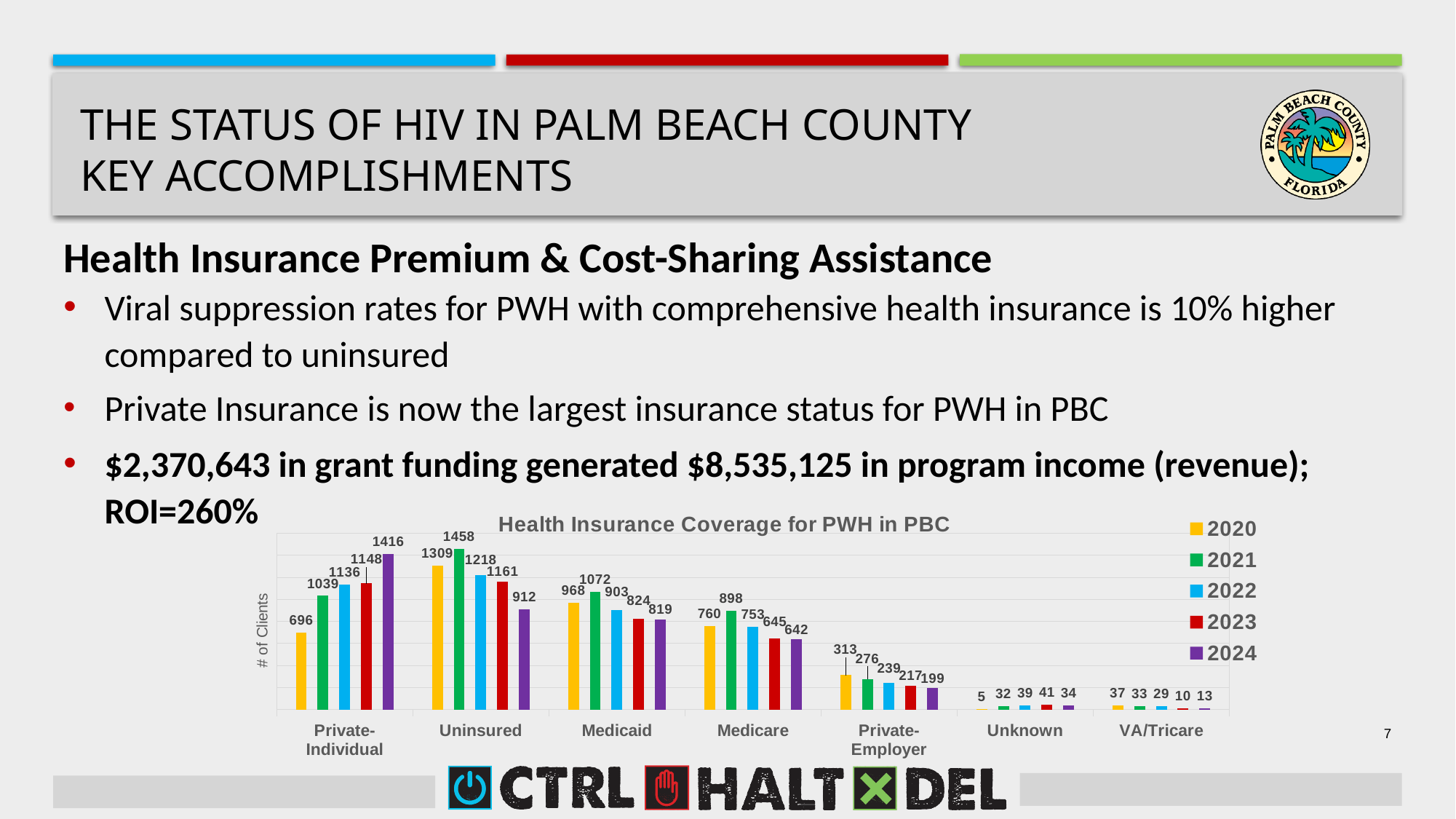
How many insurance categories are shown on the x axis? 7 What is the 2023 value for VA/Tricare? 10 What is the title of the chart? Health Insurance Coverage for PWH in PBC Which year has the highest value for Medicaid? 2021 How many series does the chart legend list? 5 What is the 2021 value for Uninsured? 1458 Which year has the lowest value for Unknown? 2020 What is the difference between the 2020 and 2024 values for Private-Individual? 720 Which is larger, the 2024 value for Uninsured or the 2024 value for Medicaid? Uninsured (912) What type of chart is shown on the slide? Bar chart What is the 2024 value for Private-Individual? 1416 Do the values for Private-Employer rise or fall from 2020 to 2024? Fall